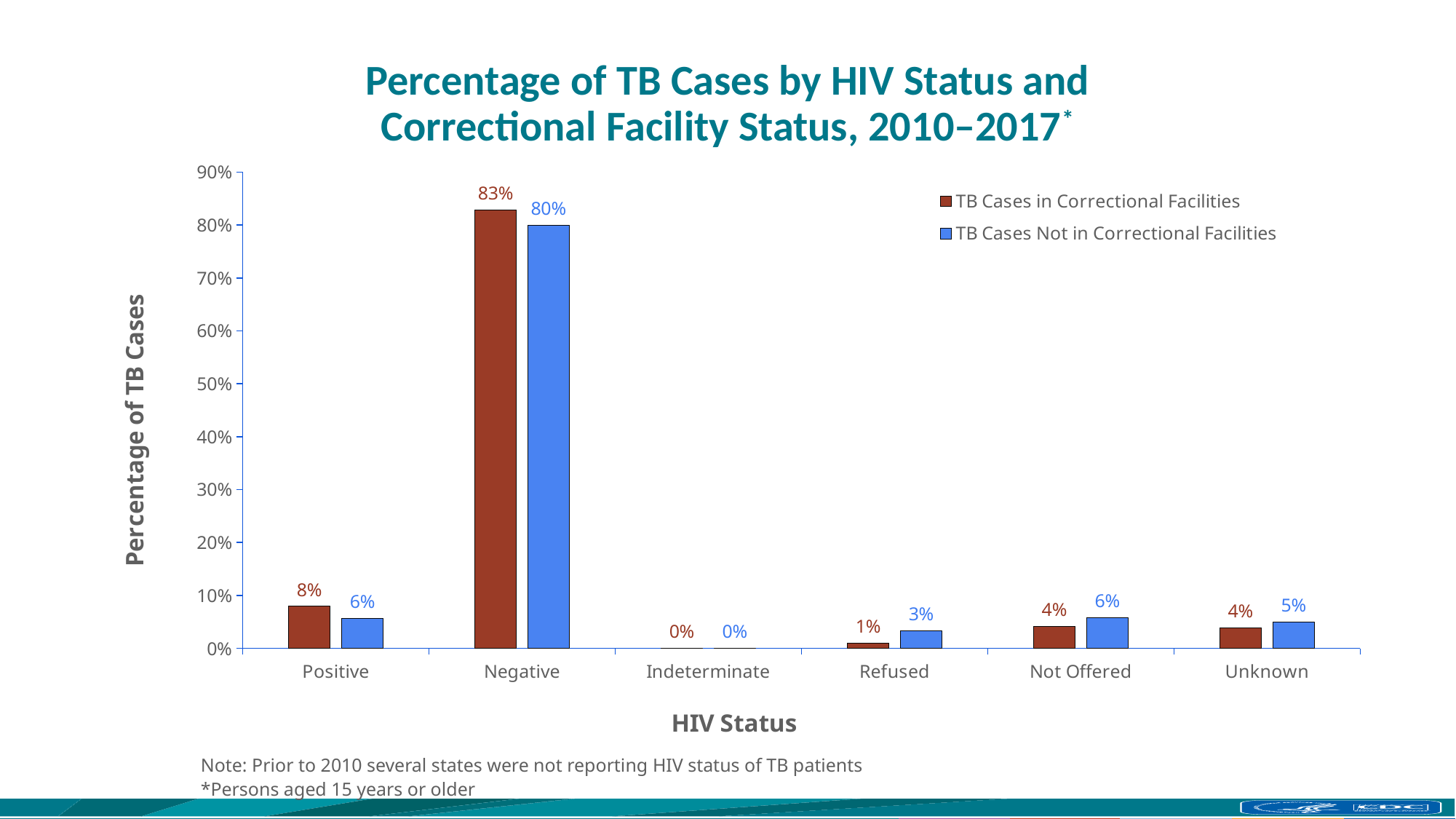
What kind of chart is shown on the slide? Bar chart How many HIV status categories are shown on the x axis? 6 What is the difference between the Negative percentages for TB cases in correctional facilities and not in correctional facilities? 3% What is the value for Refused among TB cases not in correctional facilities? 3% What is the label of the y axis? Percentage of TB Cases Which HIV status category has the highest percentage for TB cases in correctional facilities? Negative How many series does the legend list? 2 What percentage of TB cases not in correctional facilities had a Positive HIV status? 6% For the Not Offered category, which series has the larger value? TB Cases Not in Correctional Facilities Is the value for Negative among TB cases not in correctional facilities greater or less than 70%? greater What percentage of TB cases in correctional facilities had a Negative HIV status? 83% Which HIV status category has the lowest percentage for TB cases not in correctional facilities? Indeterminate